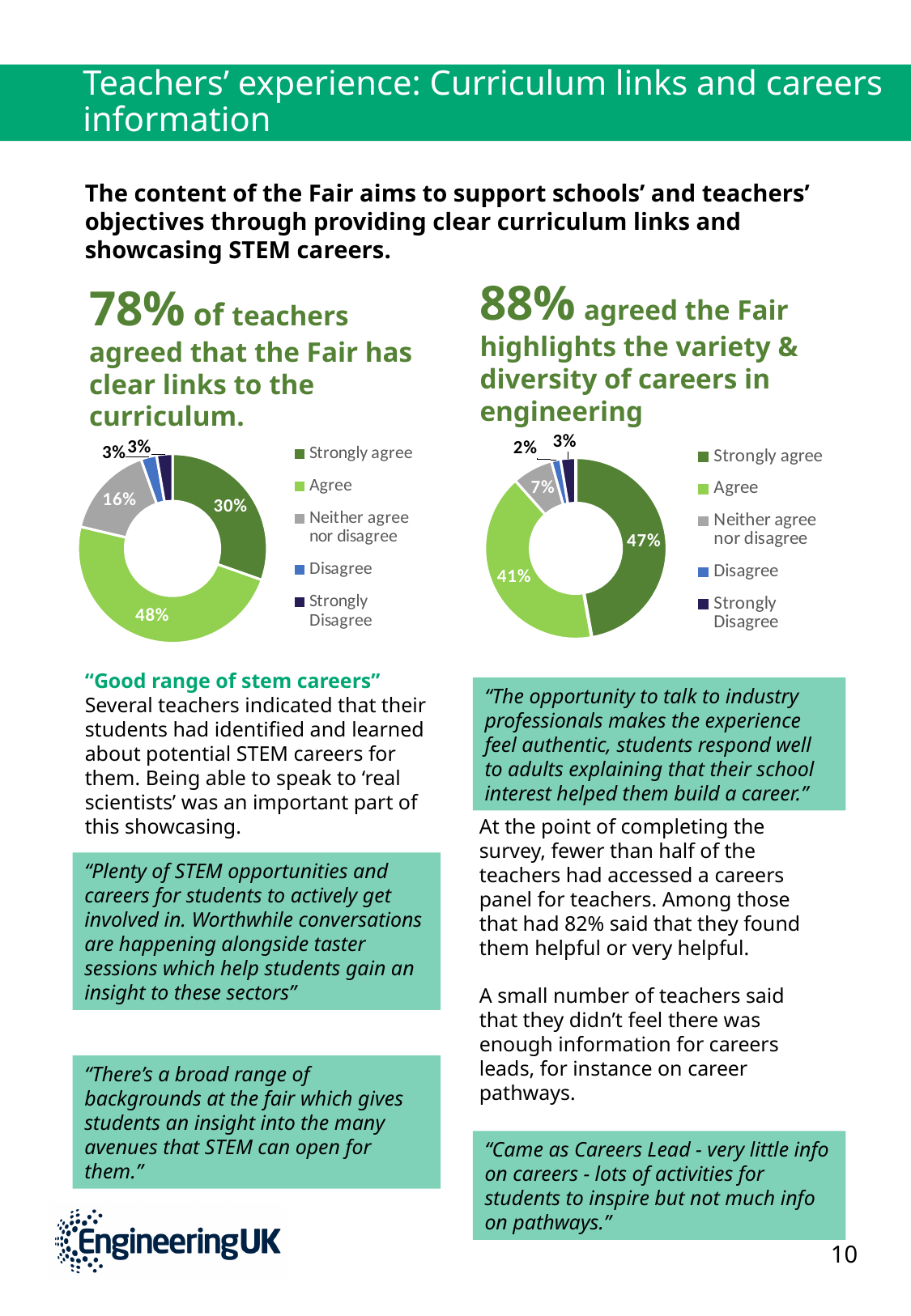
How many response categories does the legend of the left chart (clear links to the curriculum) list? 5 In the right chart (variety & diversity of careers), what is the combined share of 'Strongly agree' and 'Agree'? 88% In the left chart (clear links to the curriculum), what is the difference between the 'Agree' and 'Strongly agree' shares? 18% In the left chart (clear links to the curriculum), what percentage of teachers answered 'Agree'? 48% Which chart has a larger 'Strongly agree' share, the left chart (curriculum links) or the right chart (variety of careers)? The right chart (variety of careers) In the right chart (variety & diversity of careers), what colour represents 'Neither agree nor disagree'? Grey In the right chart (variety & diversity of careers), what percentage of teachers answered 'Strongly agree'? 47% In the right chart (variety & diversity of careers), which response category has the smallest share? Disagree What type of chart is used on this slide to show the teachers' responses? Pie (doughnut) chart In the left chart (clear links to the curriculum), what percentage answered 'Neither agree nor disagree'? 16% In the right chart (variety & diversity of careers), what percentage answered 'Disagree'? 2% In the left chart (clear links to the curriculum), which response category has the largest share? Agree